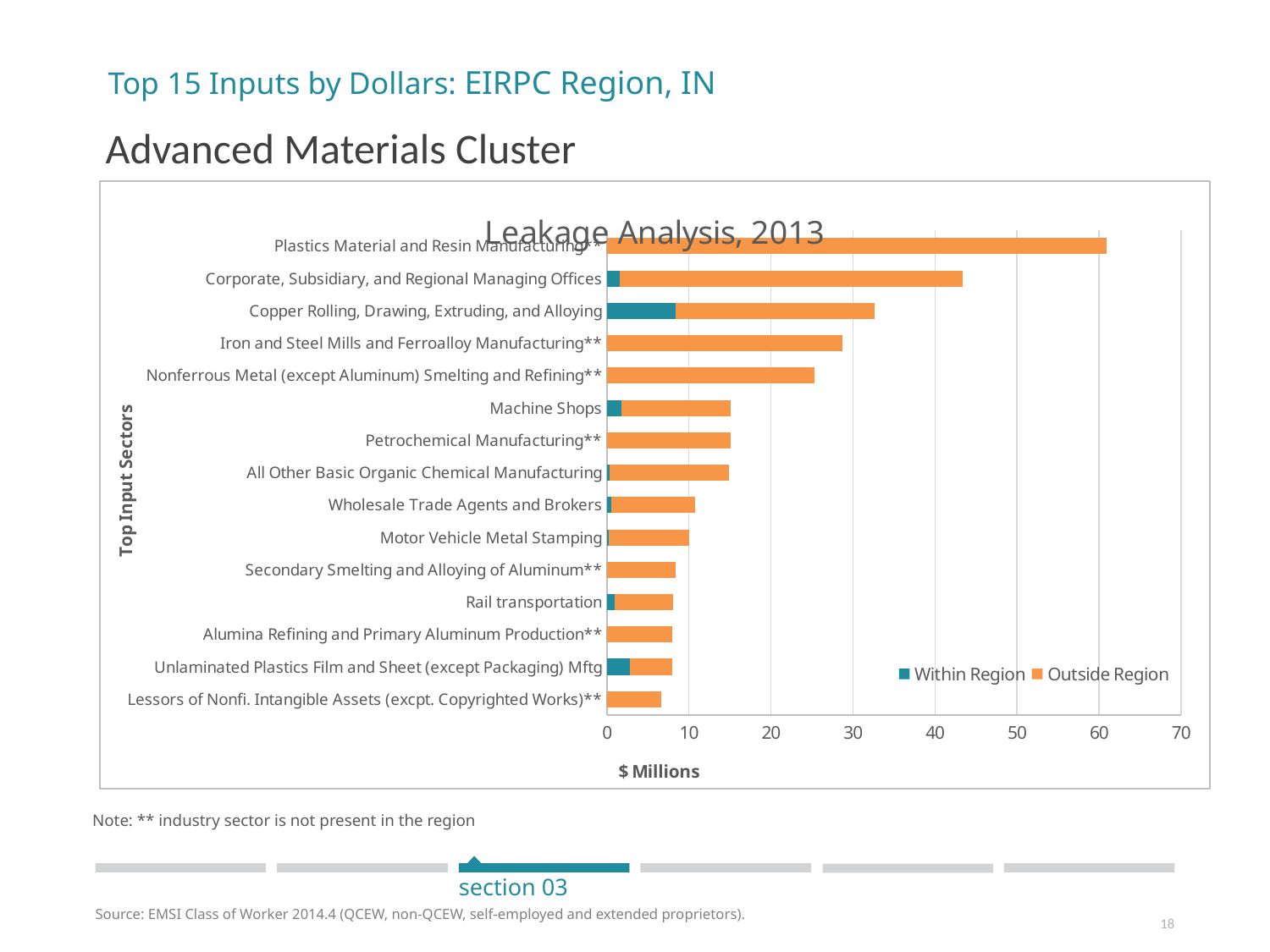
What is the title of the chart? Leakage Analysis, 2013 Which input sector has the largest Within Region value? Copper Rolling, Drawing, Extruding, and Alloying Which has a larger total value: Corporate, Subsidiary, and Regional Managing Offices or Copper Rolling, Drawing, Extruding, and Alloying? Corporate, Subsidiary, and Regional Managing Offices How many input sectors are plotted on the chart? 15 Do the total bar lengths increase or decrease going from the top sector to the bottom sector? decrease Which input sector has the shortest total bar? Lessors of Nonfi. Intangible Assets (excpt. Copyrighted Works)** Which input sector has the longest total bar? Plastics Material and Resin Manufacturing** Is the total value for Corporate, Subsidiary, and Regional Managing Offices greater or less than 40 $ Millions? greater Is the total value for Lessors of Nonfi. Intangible Assets (excpt. Copyrighted Works)** greater or less than 10 $ Millions? less Is the total value for Plastics Material and Resin Manufacturing** greater or less than 50 $ Millions? greater What kind of chart is shown on the slide? Stacked horizontal bar chart How many series does the legend list? 2